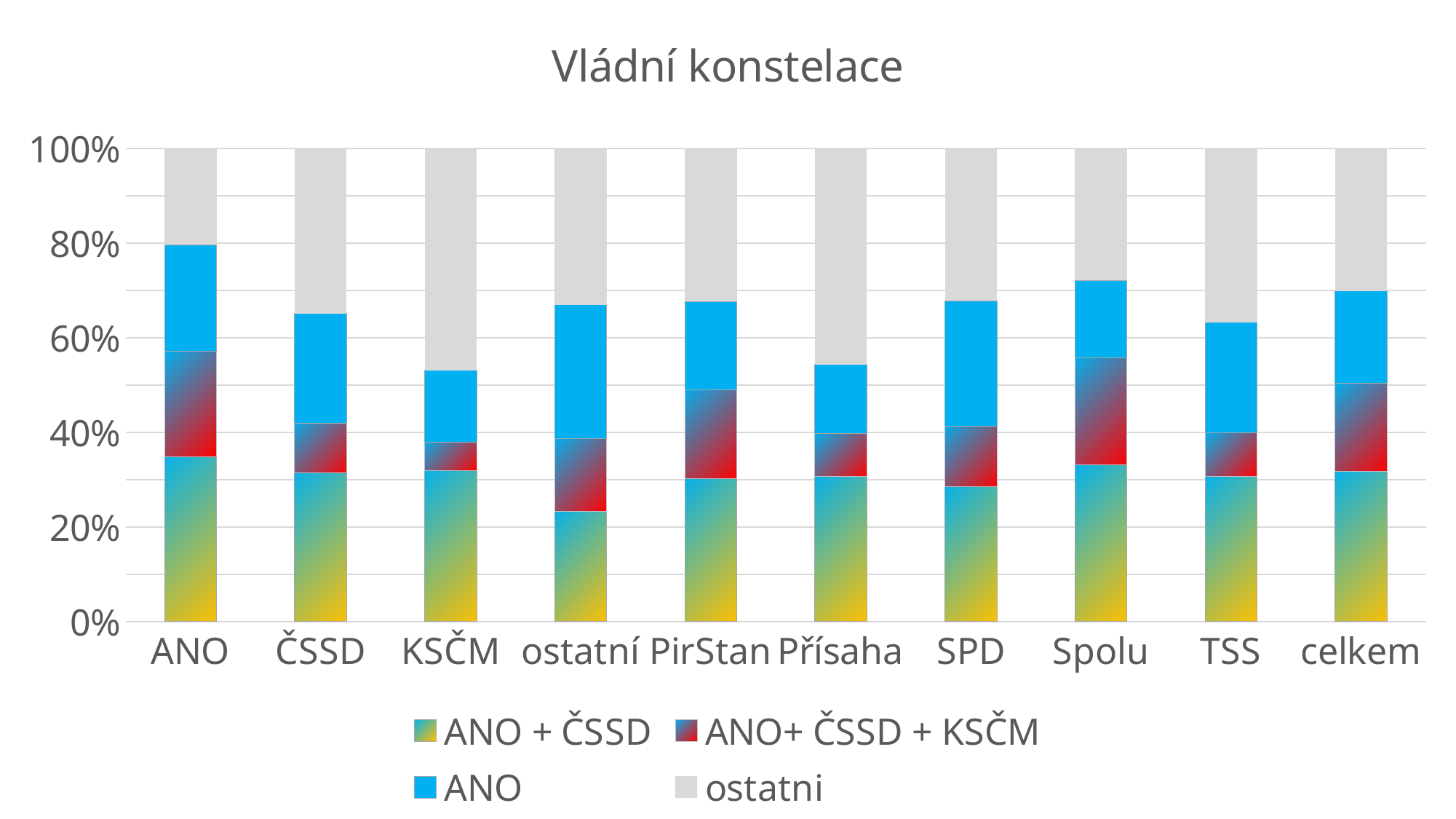
Which is larger, the 'ostatni' segment for KSČM or for ANO? KSČM How many categories are shown on the x axis? 10 Is the 'ANO + ČSSD' value for ANO greater or less than 20%? greater How many series does the legend list? 4 Which category has the smallest 'ANO + ČSSD' segment? ostatní Is the 'ostatni' segment for KSČM greater or less than 40%? greater Which category has the smallest 'ostatni' segment? ANO Which is larger, the 'ANO + ČSSD' segment for ANO or for ostatní? ANO What is the title of the chart? Vládní konstelace Is the 'ANO + ČSSD' value for ostatní greater or less than 40%? less What kind of chart is shown on the slide? stacked bar chart